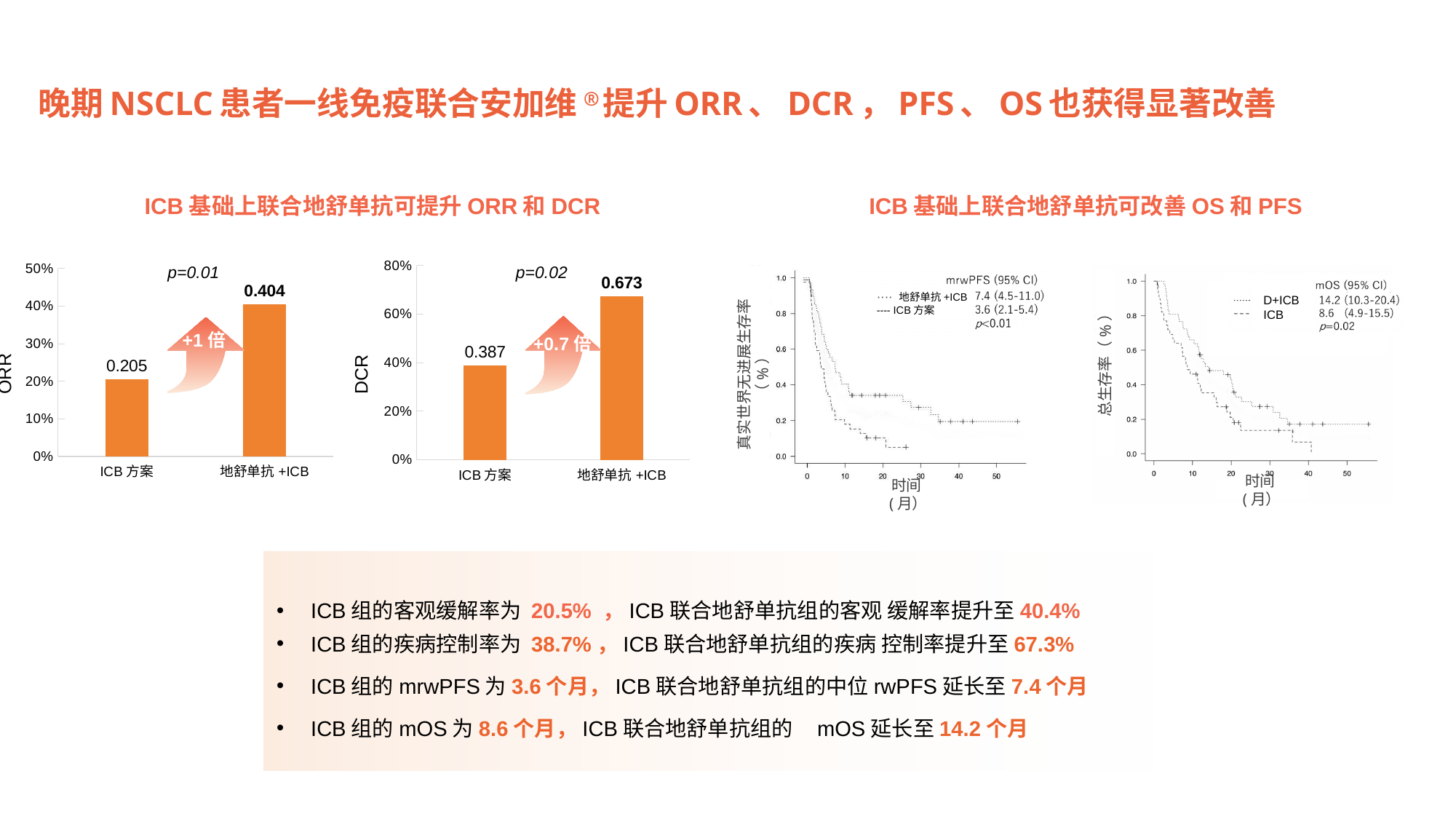
What kind of chart is the ORR chart on the left of the slide? bar chart In the mOS survival curve chart, what is the mOS value listed for D+ICB? 14.2 (10.3-20.4) In the mrwPFS survival curve chart, what is the mrwPFS value listed for ICB 方案? 3.6 (2.1-5.4) In the DCR bar chart, what is the value for ICB 方案? 0.387 In the DCR bar chart, what is the difference between the 地舒单抗+ICB bar and the ICB 方案 bar? 0.286 In the ORR bar chart, what is the value for ICB 方案? 0.205 In the DCR bar chart, which category has the lowest value? ICB 方案 In the ORR bar chart, what is the difference between the 地舒单抗+ICB bar and the ICB 方案 bar? 0.199 In the ORR bar chart, which category has the higher value? 地舒单抗+ICB In the ORR bar chart, what is the value for 地舒单抗+ICB? 0.404 How many categories are shown in the DCR bar chart? 2 In the DCR bar chart, what is the value for 地舒单抗+ICB? 0.673